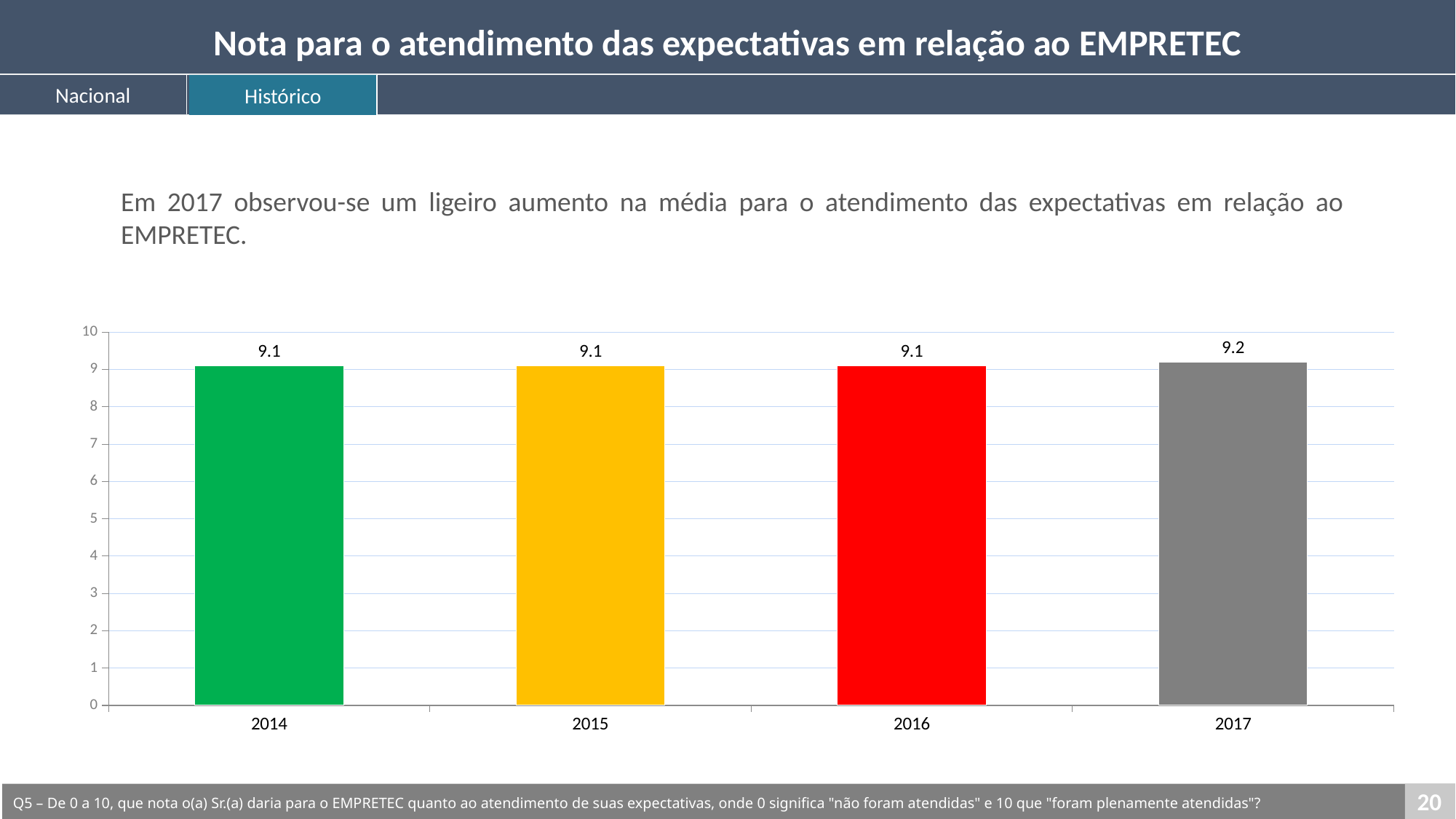
What kind of chart is shown on the slide? Bar chart What colour is the bar for 2016? Red What is the value for 2017? 9.2 What is the value for 2014? 9.1 What is the difference between the values for 2017 and 2015? 0.1 Do the values rise or fall from 2016 to 2017? rise Which year has the highest value? 2017 What is the maximum value shown on the y axis? 10 What is the value for 2016? 9.1 Is the value for 2015 greater or less than 8? greater How many years are shown on the x axis? 4